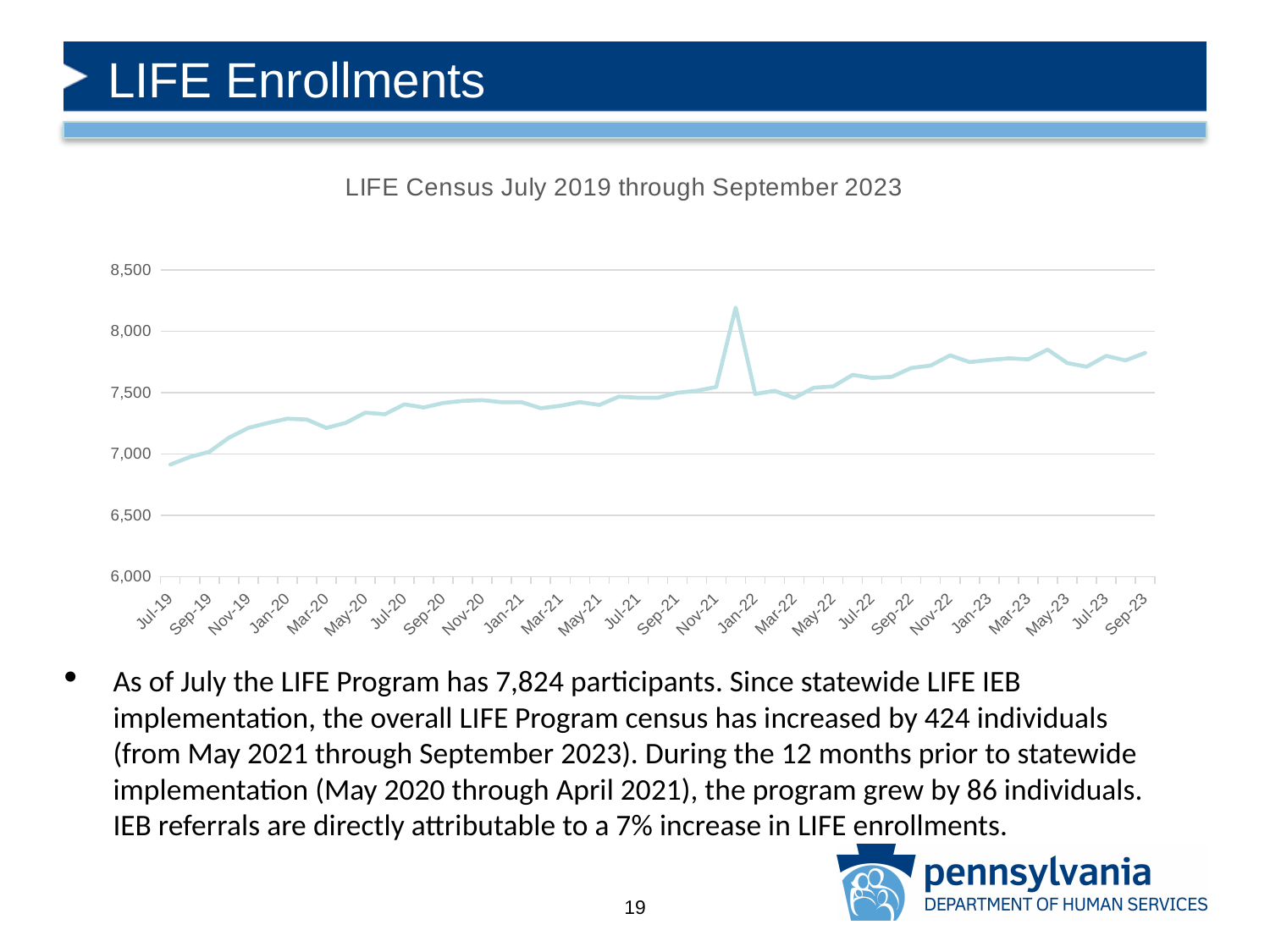
What is the highest value shown on the vertical axis? 8,500 Which of Jan-20 and Jan-23 has the larger value? Jan-23 Is the value for Mar-20 greater or less than 7,000? greater What is the title of the chart? LIFE Census July 2019 through September 2023 What kind of chart is shown on the slide? line chart Is the value for Jul-19 greater or less than 7,000? less Is the value for Jan-21 greater or less than 7,500? less Which month has the lowest value on the chart? Jul-19 Which of Jul-19 and Sep-23 has the larger value? Sep-23 Overall, do the values rise or fall from Jul-19 to Sep-23? rise